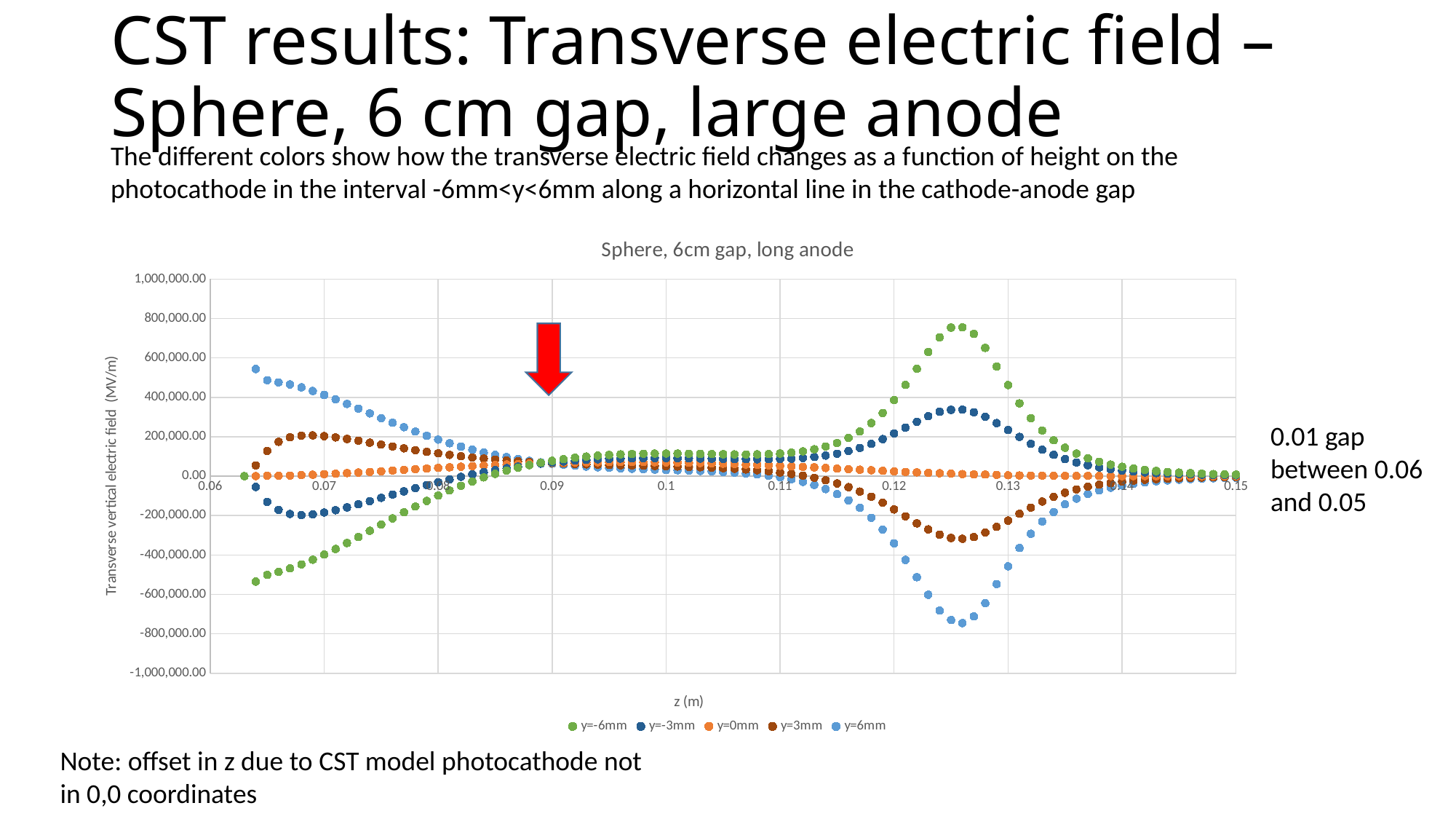
Near z = 0.07, which series has the larger value: y=3mm or y=-3mm? y=3mm Is the value of the y=0mm series at z = 0.13 greater or less than 200,000.00? less Is the lowest value of the y=6mm series near z = 0.125 greater or less than -600,000.00? less Which series reaches the highest value anywhere on the chart? y=-6mm Is the value of the y=6mm series at its first point near z = 0.06 greater or less than 400,000.00? greater What is the title of the chart? Sphere, 6cm gap, long anode How many series does the chart legend list? 5 Which series reaches the lowest value anywhere on the chart? y=6mm What is the label of the x axis of the chart? z (m) What kind of chart is shown on the slide? scatter chart Near z = 0.125, which series has the larger value: y=-6mm or y=-3mm? y=-6mm